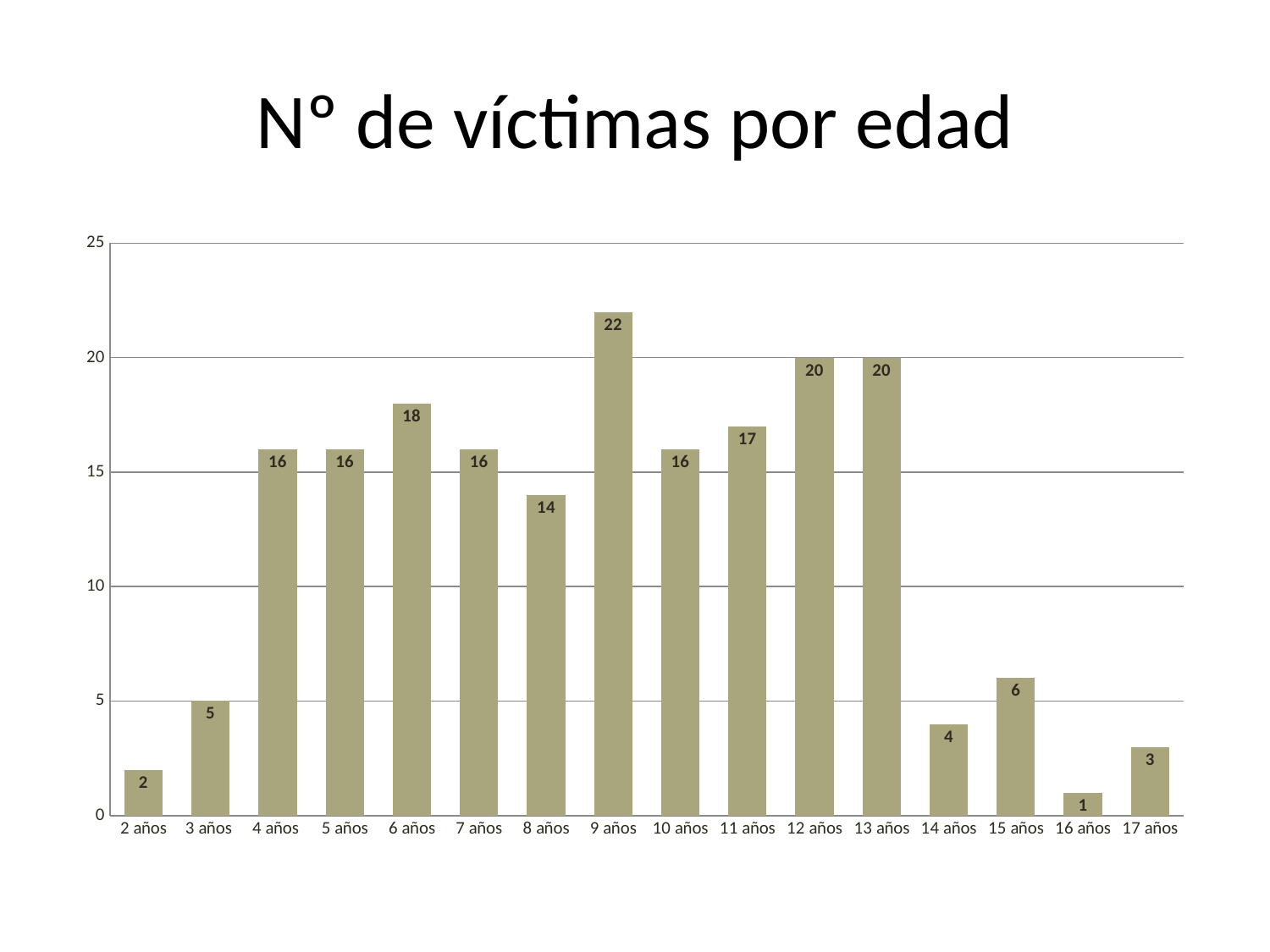
Which age has the highest number of victims? 9 años How many age categories are shown on the x axis? 16 What is the title of the chart? Nº de víctimas por edad Is the value for 12 años greater or less than 15? greater What kind of chart is shown on the slide? Bar chart What is the difference between the values for 9 años and 8 años? 8 What is the number of victims for 16 años? 1 Which age has the lowest number of victims? 16 años Which has more victims, 11 años or 15 años? 11 años Do the values rise or fall from 13 años to 16 años? Fall What is the number of victims for 9 años? 22 What is the number of victims for 6 años? 18